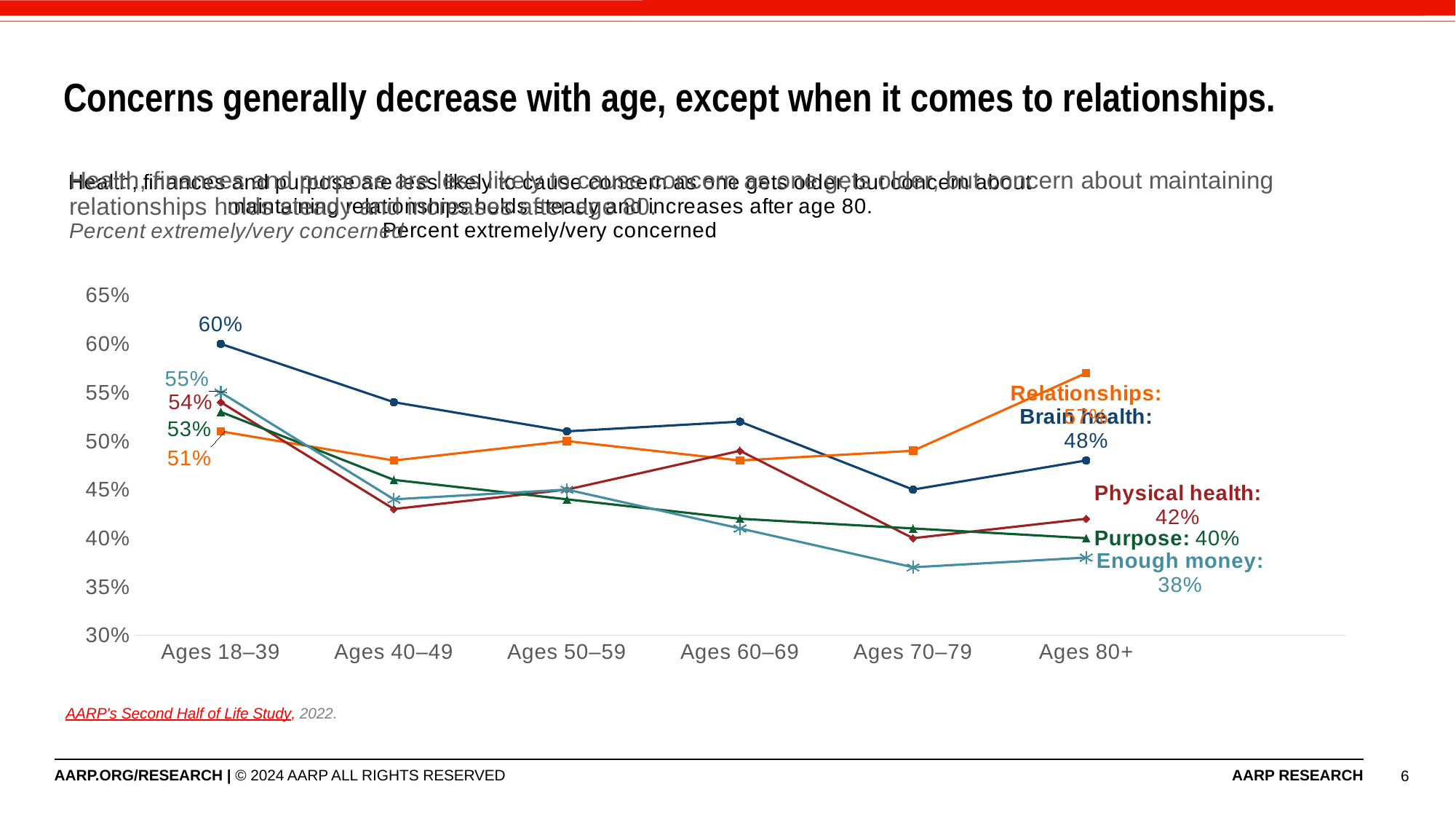
What is the value for Enough money at Ages 80+? 38% At Ages 80+, which is larger: Physical health or Purpose? Physical health How many age groups are shown on the x axis? 6 Which concern has the highest value at Ages 18–39? Brain health By how many percentage points does Brain health fall from Ages 18–39 to Ages 80+? 12 percentage points What kind of chart is shown on the slide? Line chart How many concern lines are plotted on the chart? 5 What is the value for Relationships at Ages 18–39? 51% What is the value for Physical health at Ages 80+? 42% What is the value for Brain health at Ages 18–39? 60% Is the value for Relationships at Ages 80+ greater or less than 55%? greater Which concern has the lowest value at Ages 80+? Enough money